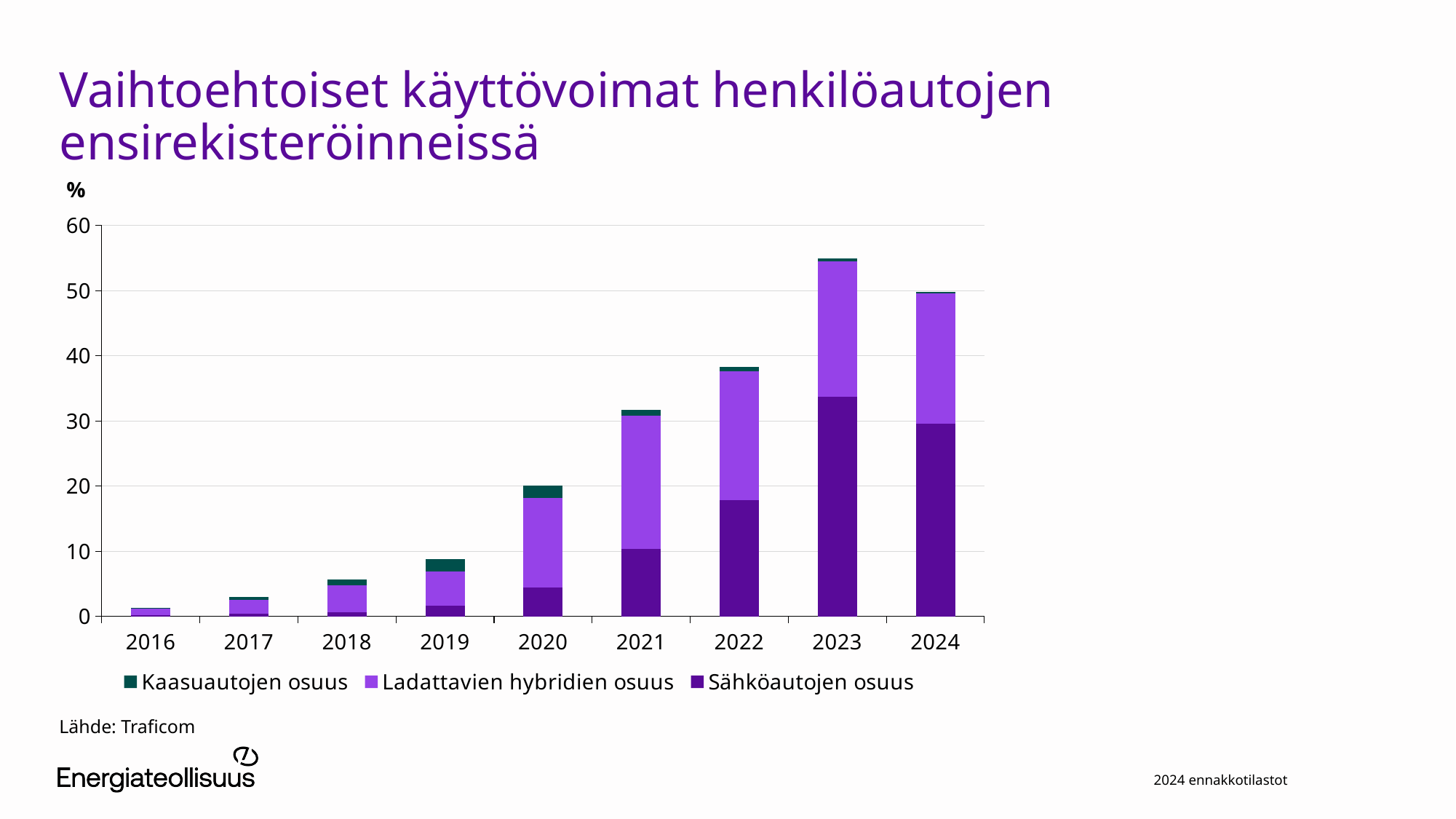
Which year has the shortest stacked bar in the chart? 2016 Which year has the tallest stacked bar in the chart? 2023 How many series does the chart's legend list? 3 What kind of chart is shown on the slide? Stacked bar chart Is the total stacked bar for 2024 greater or less than 40? greater How do the total stacked bar values change from 2016 to 2023? They rise every year Is the Sähköautojen osuus segment for 2023 greater or less than 30? greater Which year has the larger total stacked bar, 2023 or 2024? 2023 Is the total stacked bar for 2019 greater or less than 10? less How many years are shown on the x axis of the chart? 9 What source is cited below the chart? Traficom